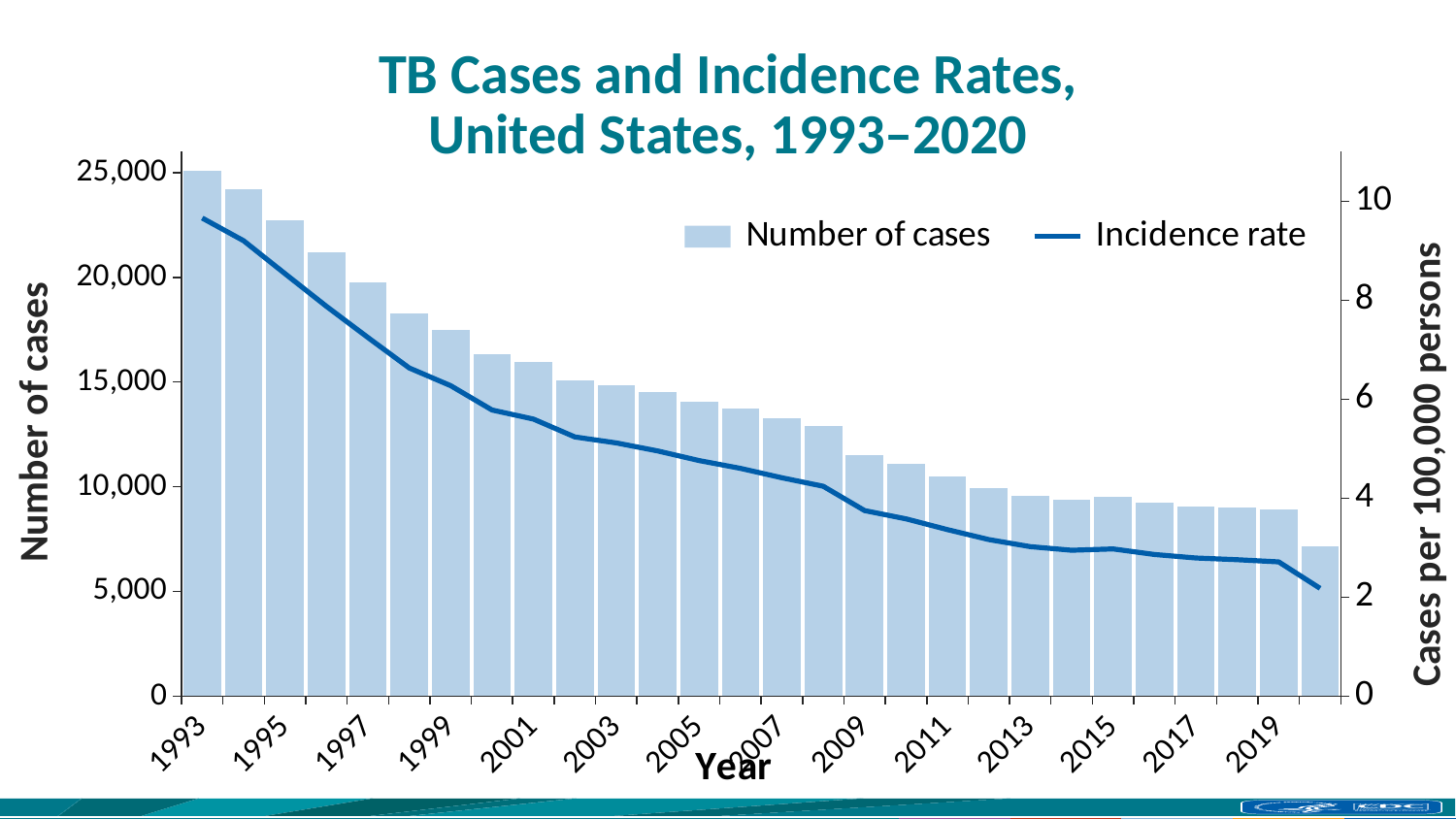
Is the number of cases for 1995 greater or less than 20,000? greater What kind of chart is shown on the slide? A combined bar and line chart Is the incidence rate for 2003 greater or less than 6 cases per 100,000 persons? less How many series does the legend list? 2 Is the number of cases for 2020 greater or less than 10,000? less Do the number of cases rise or fall from 1993 to 2020? Fall How many years (bars) are plotted in the chart? 28 Which year has more TB cases, 2009 or 2019? 2009 Which year has the highest number of TB cases? 1993 Which year has the lowest number of TB cases? 2020 What are the two series named in the legend? Number of cases and Incidence rate